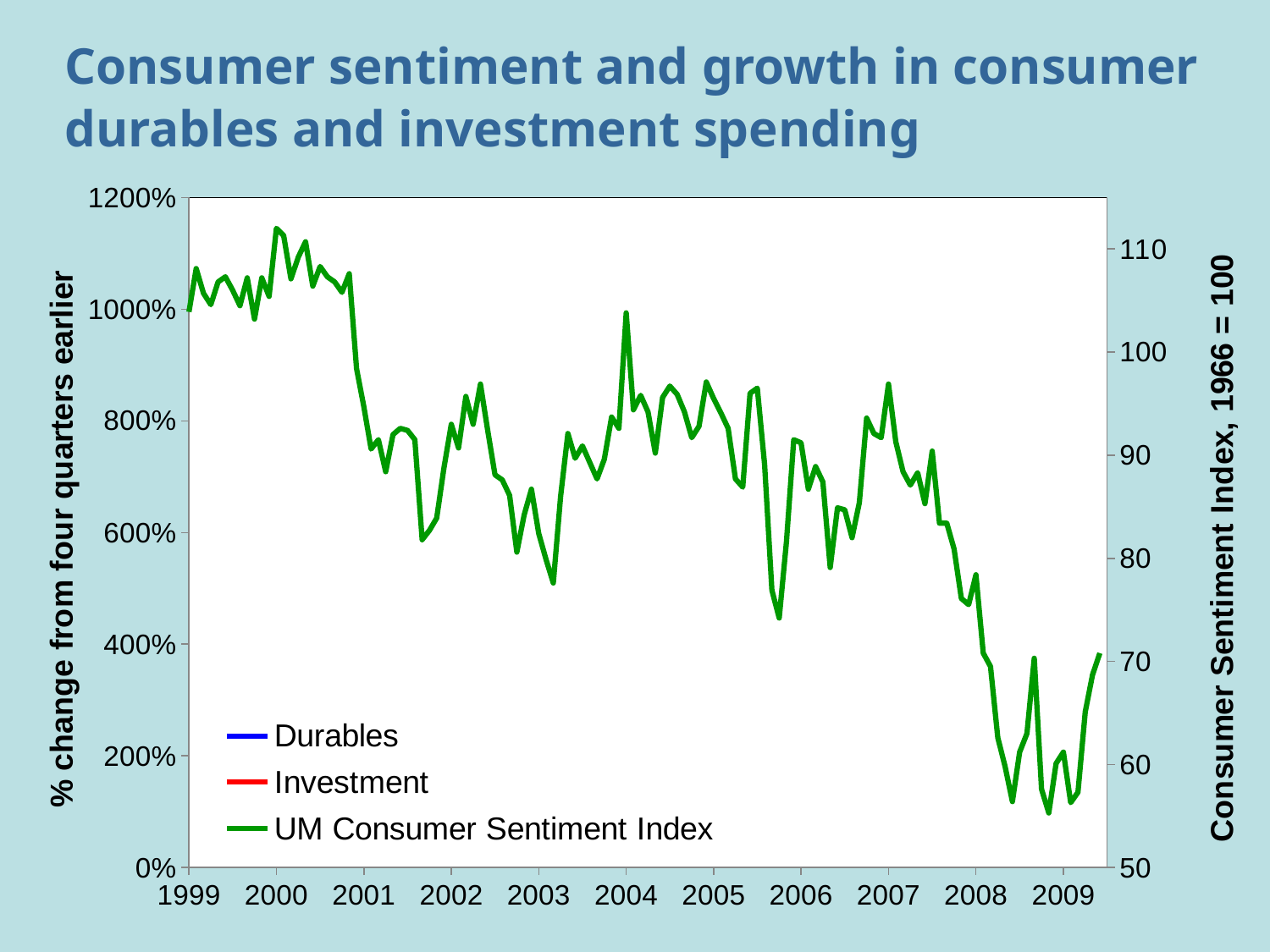
How many series does the legend list? 3 What kind of chart is shown on the slide? line chart Does the UM Consumer Sentiment Index generally rise or fall from 1999 to 2009? fall Is the UM Consumer Sentiment Index at the start of 1999 greater or less than 100 on the right-hand axis? greater In which year does the UM Consumer Sentiment Index reach its lowest value? 2008 Which series is drawn in green in the legend? UM Consumer Sentiment Index Is the peak of the UM Consumer Sentiment Index in 2000 greater or less than 110 on the right-hand axis? greater Which is higher, the UM Consumer Sentiment Index at the start of 1999 or at the start of 2009? 1999 In which year does the UM Consumer Sentiment Index reach its highest value? 2000 How many years are labelled on the x axis? 11 What is the label of the right-hand vertical axis? Consumer Sentiment Index, 1966 = 100